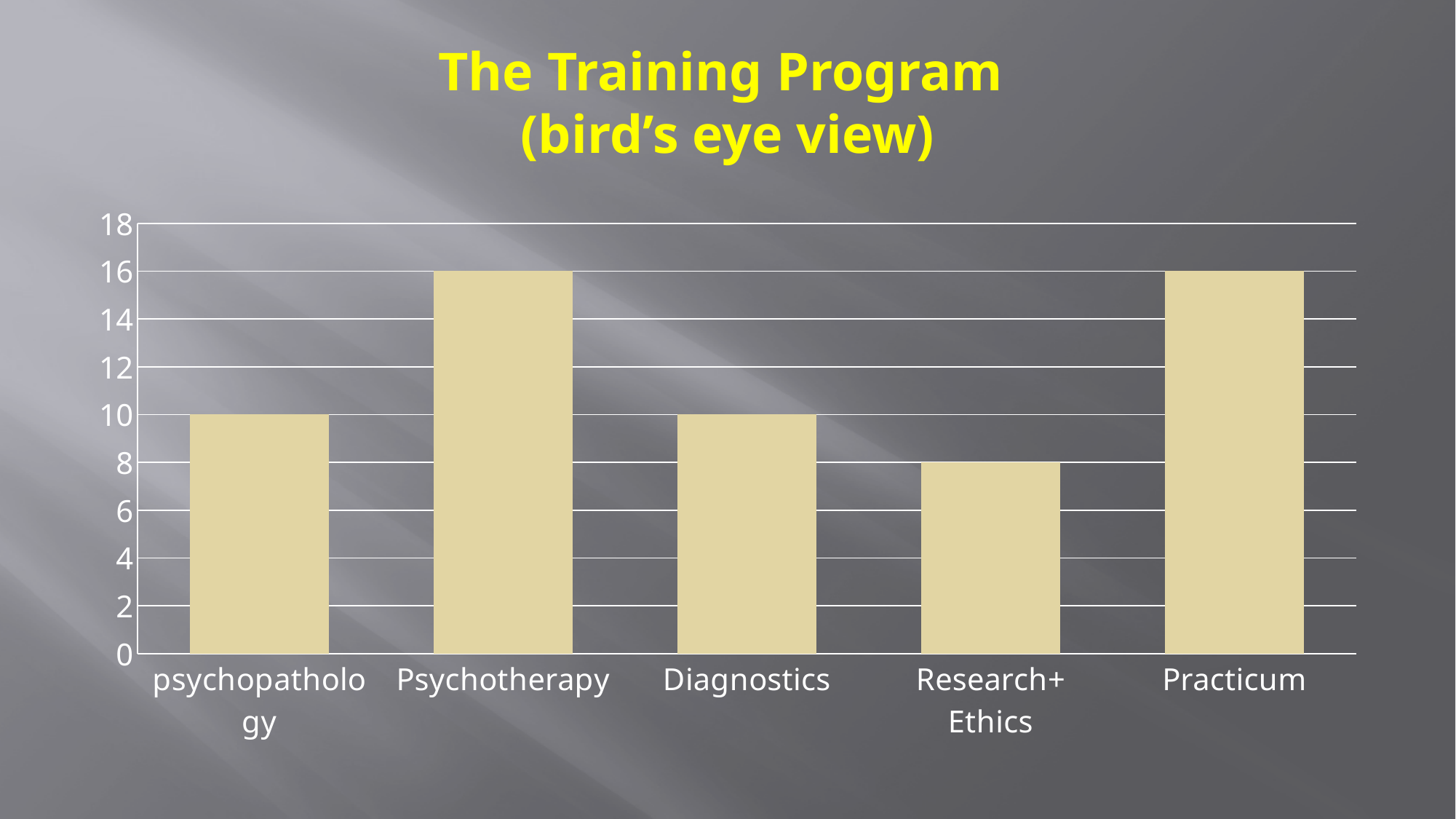
What is the difference between the values for Practicum and Diagnostics? 6 What is the value for Diagnostics? 10 What is the difference between the values for Psychotherapy and Research+ Ethics? 8 What is the value for Psychotherapy? 16 Is the value for psychopathology greater or less than 12? less What is the title of the slide? The Training Program (bird's eye view) What is the value for Research+ Ethics? 8 How many categories are shown on the x axis? 5 What kind of chart is shown on the slide? bar chart Which category has the lowest value? Research+ Ethics What is the value for Practicum? 16 Which is larger, the value for Psychotherapy or the value for Diagnostics? Psychotherapy